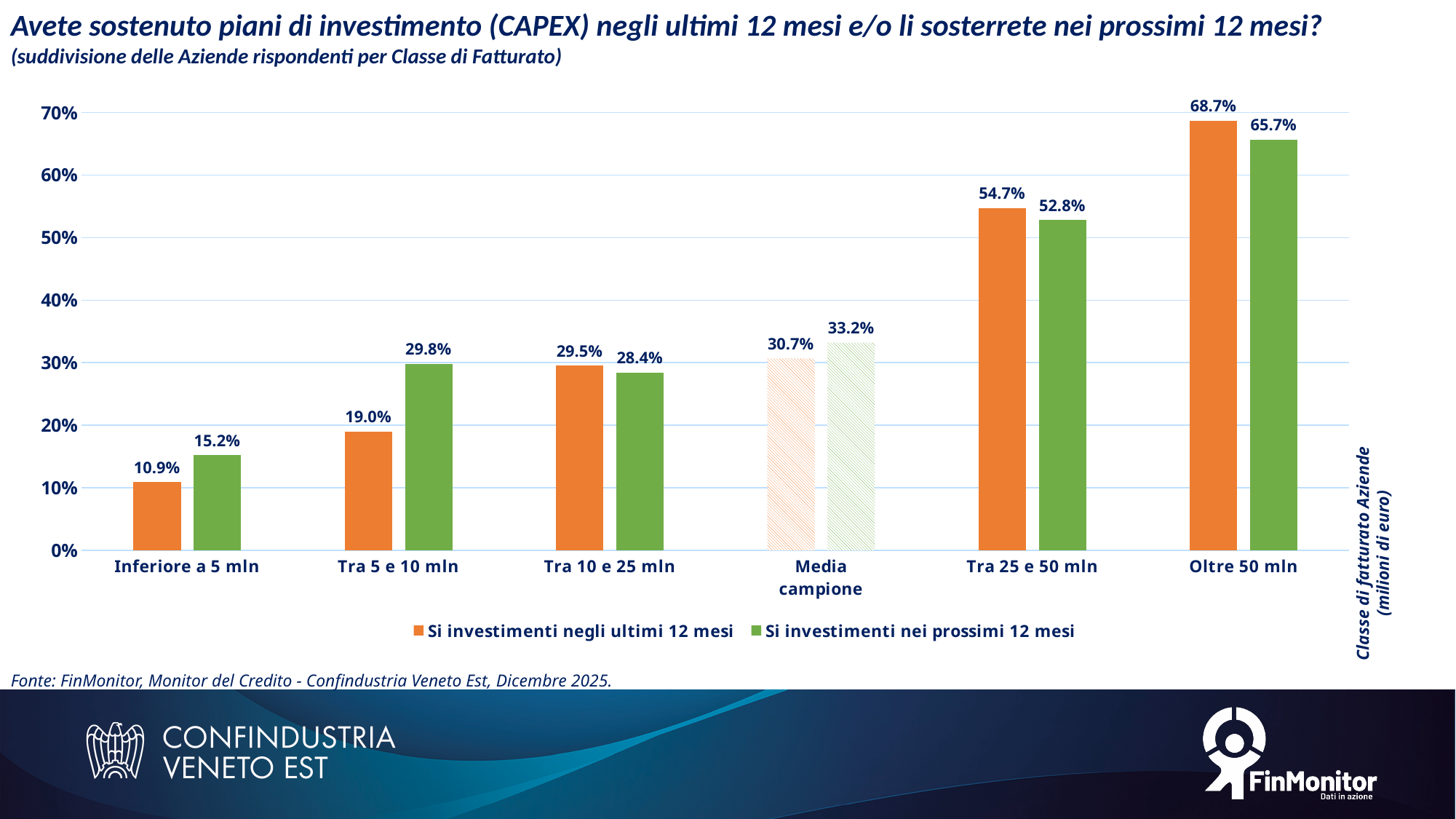
What is the difference between the two series for 'Inferiore a 5 mln'? 4.3% Is the value for 'Tra 10 e 25 mln' in 'Si investimenti negli ultimi 12 mesi' greater or less than 30%? less What is the 'Media campione' value for 'Si investimenti nei prossimi 12 mesi'? 33.2% What is the value for 'Tra 5 e 10 mln' in the series 'Si investimenti negli ultimi 12 mesi'? 19.0% For 'Tra 25 e 50 mln', which series has the larger value? Si investimenti negli ultimi 12 mesi What kind of chart is shown on the slide? bar chart Which colour represents 'Si investimenti nei prossimi 12 mesi' in the legend? green Which category has the lowest value for 'Si investimenti nei prossimi 12 mesi'? Inferiore a 5 mln What is the value for 'Oltre 50 mln' in the series 'Si investimenti nei prossimi 12 mesi'? 65.7% Which category has the highest value for 'Si investimenti negli ultimi 12 mesi'? Oltre 50 mln How many categories are shown on the x axis? 6 How many series does the legend list? 2